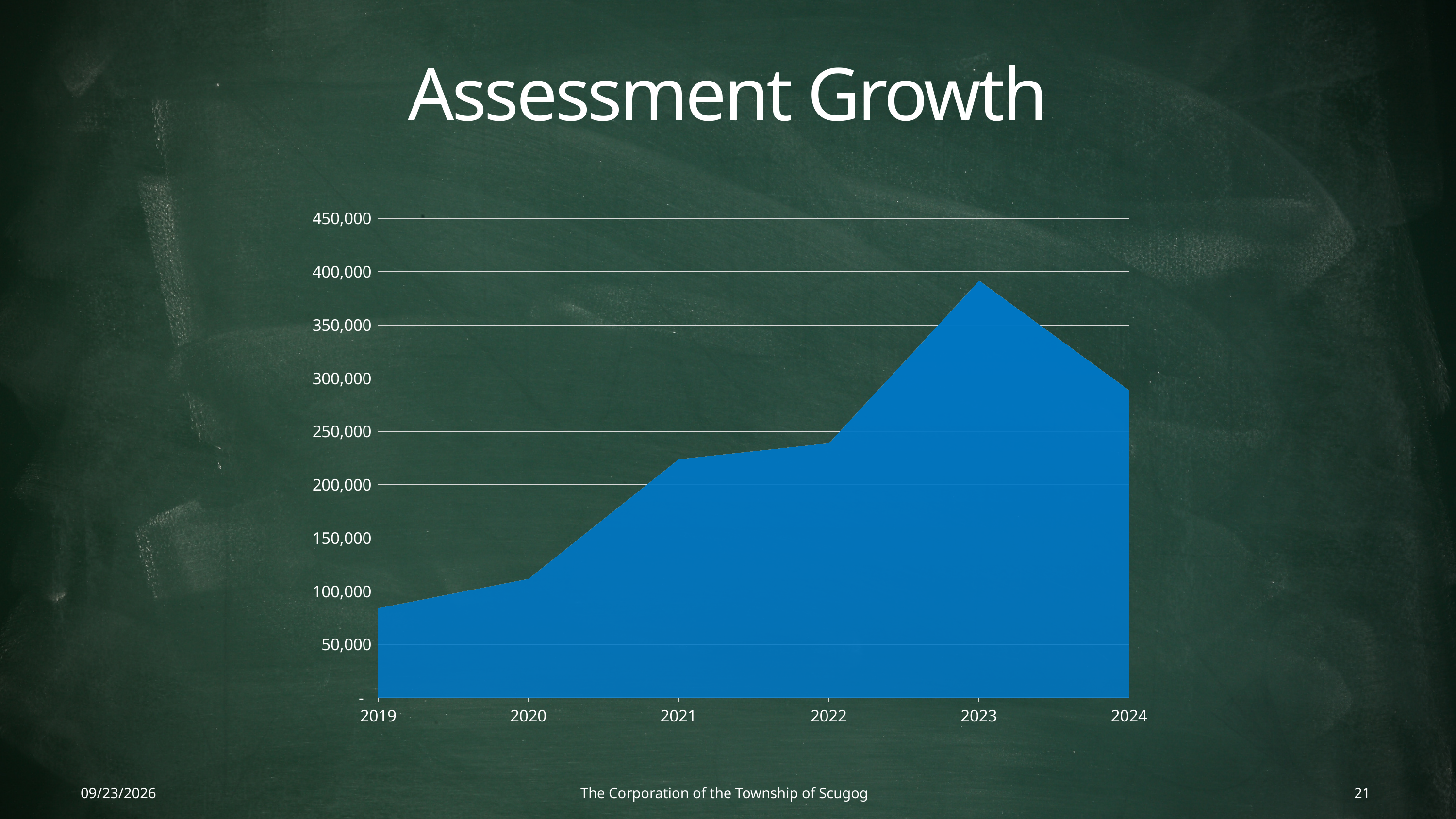
Which is larger, the value for 2023 or the value for 2024? 2023 Which year has the highest value? 2023 How do the values change from 2019 to 2023? They rise Is the value for 2023 greater or less than 350,000? greater What is the title of the chart? Assessment Growth Is the value for 2024 greater or less than 300,000? less What type of chart is shown on the slide? Area chart Is the value for 2021 greater or less than 200,000? greater Which year has the lowest value? 2019 Which is larger, the value for 2020 or the value for 2021? 2021 How many years are plotted along the x axis? 6